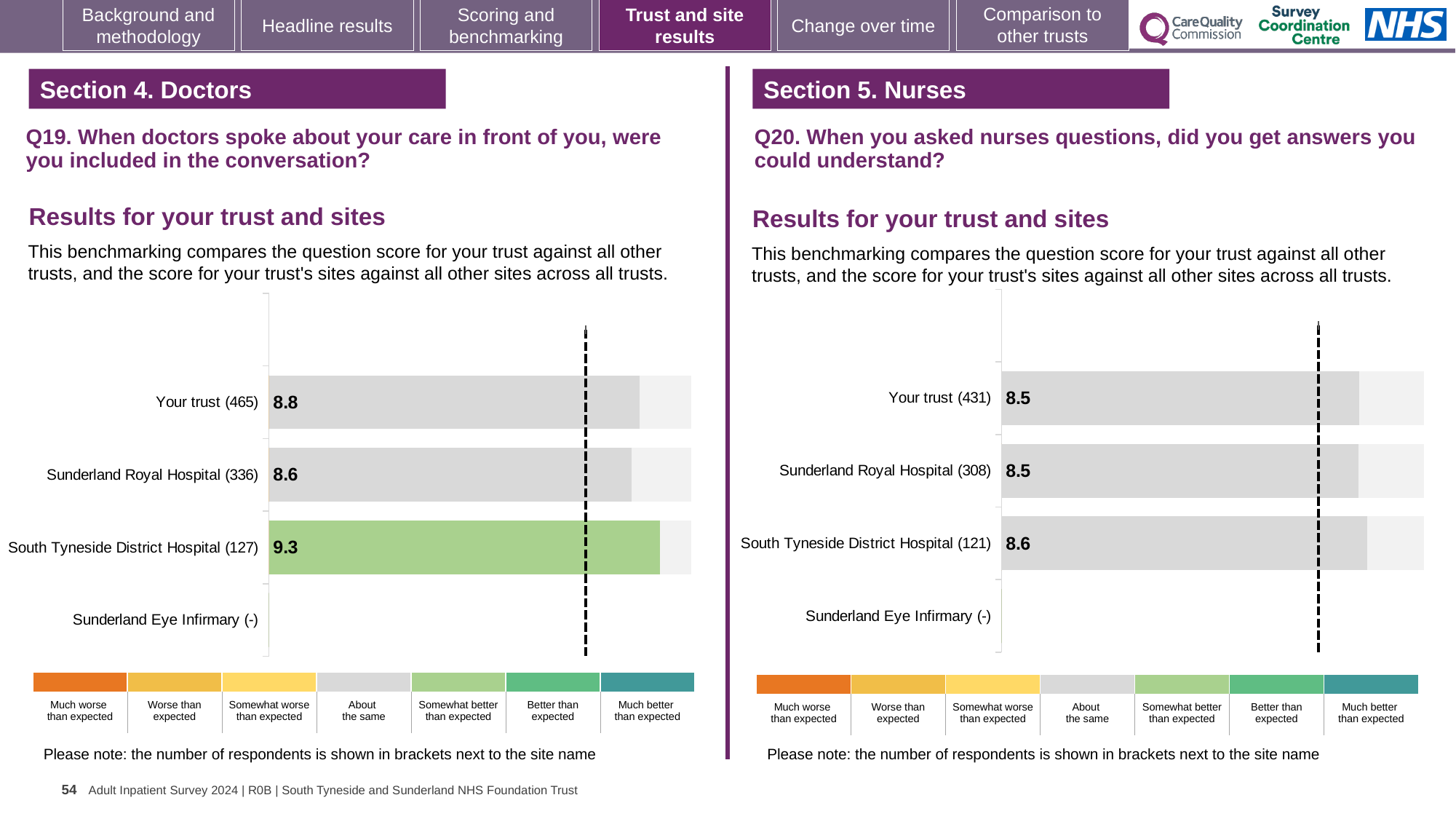
What kind of chart is used on the Q20 chart (right)? Bar chart On the Q20 chart (right), what is the difference between the scores for South Tyneside District Hospital and Your trust? 0.1 On the Q20 chart (right), what is the score for Sunderland Royal Hospital? 8.5 On the Q19 chart (left), which site or trust has the highest score? South Tyneside District Hospital On the Q19 chart (left), which site has no score shown (marked with a dash)? Sunderland Eye Infirmary On the Q19 chart (left), what is the score for South Tyneside District Hospital? 9.3 On the Q19 chart (left), which has the larger score, Your trust or Sunderland Royal Hospital? Your trust On the Q20 chart (right), how many respondents are shown in brackets for Your trust? 431 On the Q19 chart (left), what is the difference between the scores for South Tyneside District Hospital and Sunderland Royal Hospital? 0.7 On the Q20 chart (right), what is the score for South Tyneside District Hospital? 8.6 On the Q19 chart (left), how many respondents are shown in brackets for Sunderland Royal Hospital? 336 On the Q19 chart (left), what is the score for Your trust? 8.8